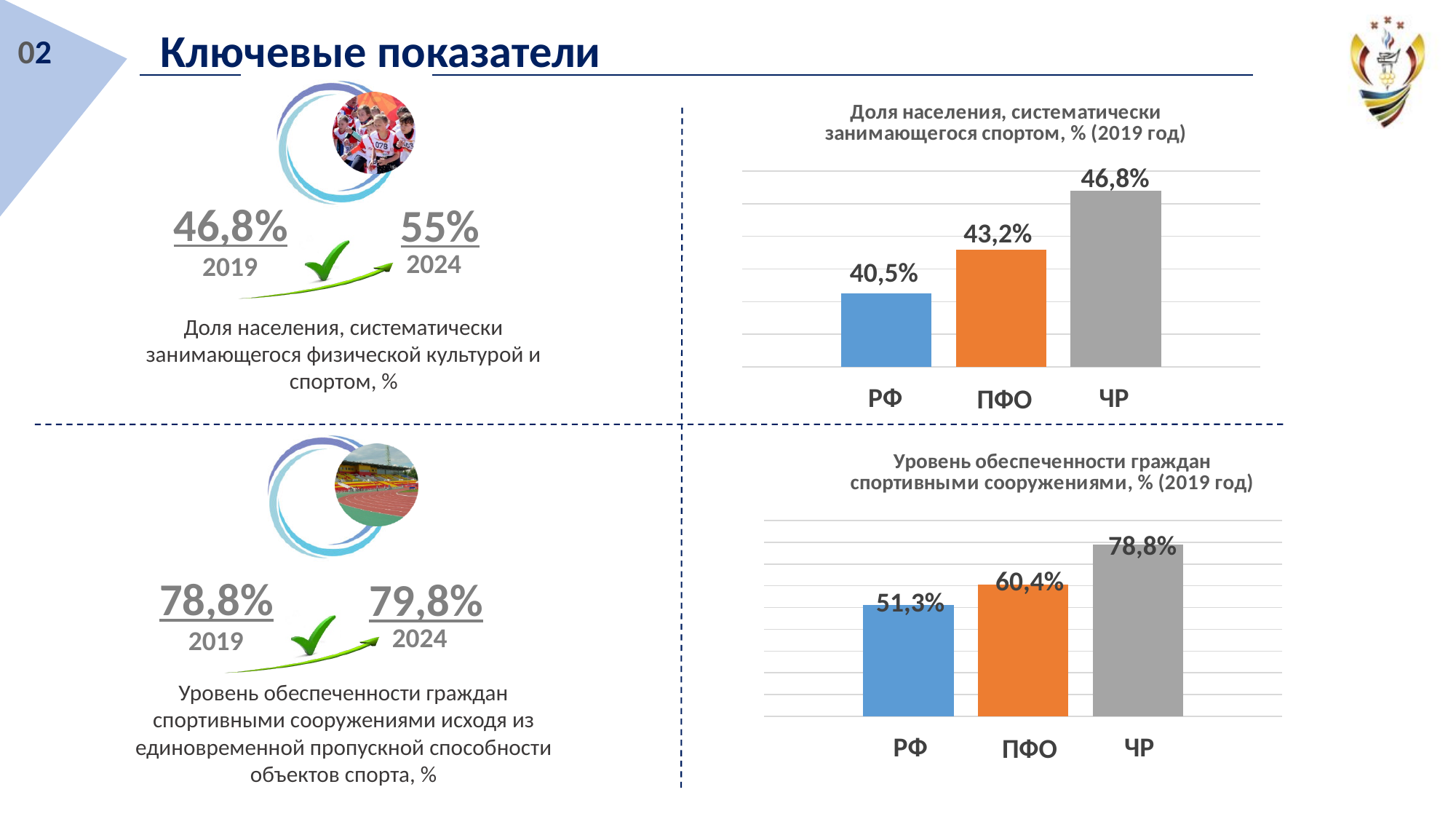
In the bottom chart (Уровень обеспеченности граждан спортивными сооружениями), what is the difference between the values for ЧР and РФ? 27,5% In the top chart (Доля населения, систематически занимающегося спортом), which category has the highest value? ЧР In the top chart (Доля населения, систематически занимающегося спортом), what is the value for РФ? 40,5% In the bottom chart (Уровень обеспеченности граждан спортивными сооружениями), which category has the lowest value? РФ In the top chart (Доля населения, систематически занимающегося спортом), what is the difference between the values for ЧР and РФ? 6,3% In the top chart (Доля населения, систематически занимающегося спортом), which category has the lowest value? РФ In the bottom chart (Уровень обеспеченности граждан спортивными сооружениями), what is the value for ПФО? 60,4% In the bottom chart (Уровень обеспеченности граждан спортивными сооружениями), what is the value for ЧР? 78,8% In the bottom chart (Уровень обеспеченности граждан спортивными сооружениями), which is larger, the value for ПФО or the value for РФ? ПФО How many categories are shown in the top chart (Доля населения, систематически занимающегося спортом)? 3 What kind of chart is the bottom chart (Уровень обеспеченности граждан спортивными сооружениями)? Bar chart In the top chart (Доля населения, систематически занимающегося спортом), what is the value for ПФО? 43,2%